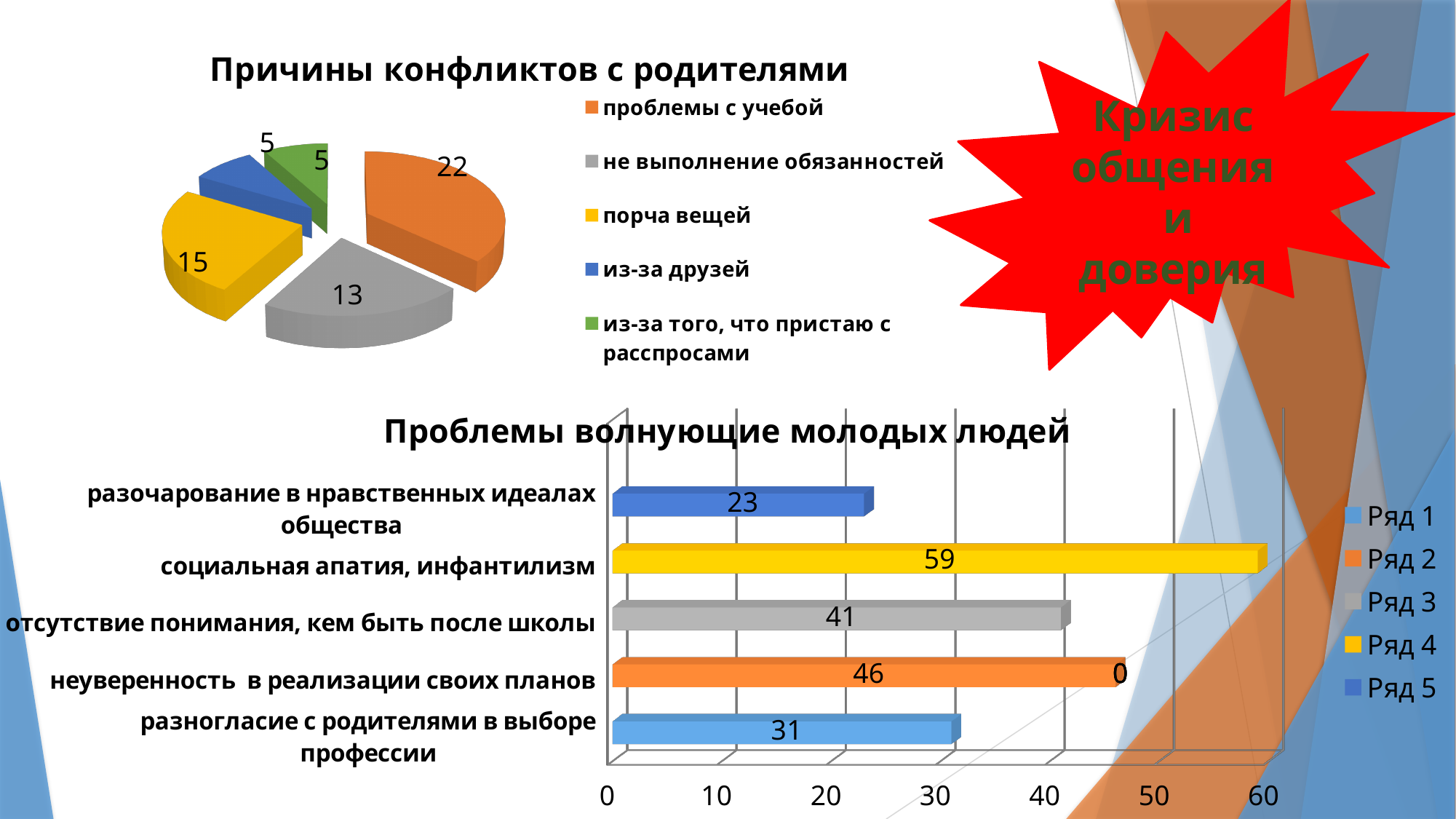
In the chart 'Проблемы волнующие молодых людей', what is the value for 'социальная апатия, инфантилизм'? 59 In the chart 'Причины конфликтов с родителями', what share of the pie does 'порча вещей' represent? 25% In the chart 'Проблемы волнующие молодых людей', which category has the lowest value? разочарование в нравственных идеалах общества What kind of chart is 'Проблемы волнующие молодых людей'? bar chart In the chart 'Проблемы волнующие молодых людей', how many categories are shown? 5 What kind of chart is 'Причины конфликтов с родителями'? pie chart In the chart 'Проблемы волнующие молодых людей', what is the value for 'разногласие с родителями в выборе профессии'? 31 In the chart 'Причины конфликтов с родителями', what is the value for 'проблемы с учебой'? 22 In the chart 'Причины конфликтов с родителями', what is the difference between 'проблемы с учебой' and 'не выполнение обязанностей'? 9 In the chart 'Причины конфликтов с родителями', which category has the highest value? проблемы с учебой In the chart 'Причины конфликтов с родителями', what is the value for 'порча вещей'? 15 In the chart 'Проблемы волнующие молодых людей', which is larger: 'отсутствие понимания, кем быть после школы' or 'неуверенность в реализации своих планов'? неуверенность в реализации своих планов